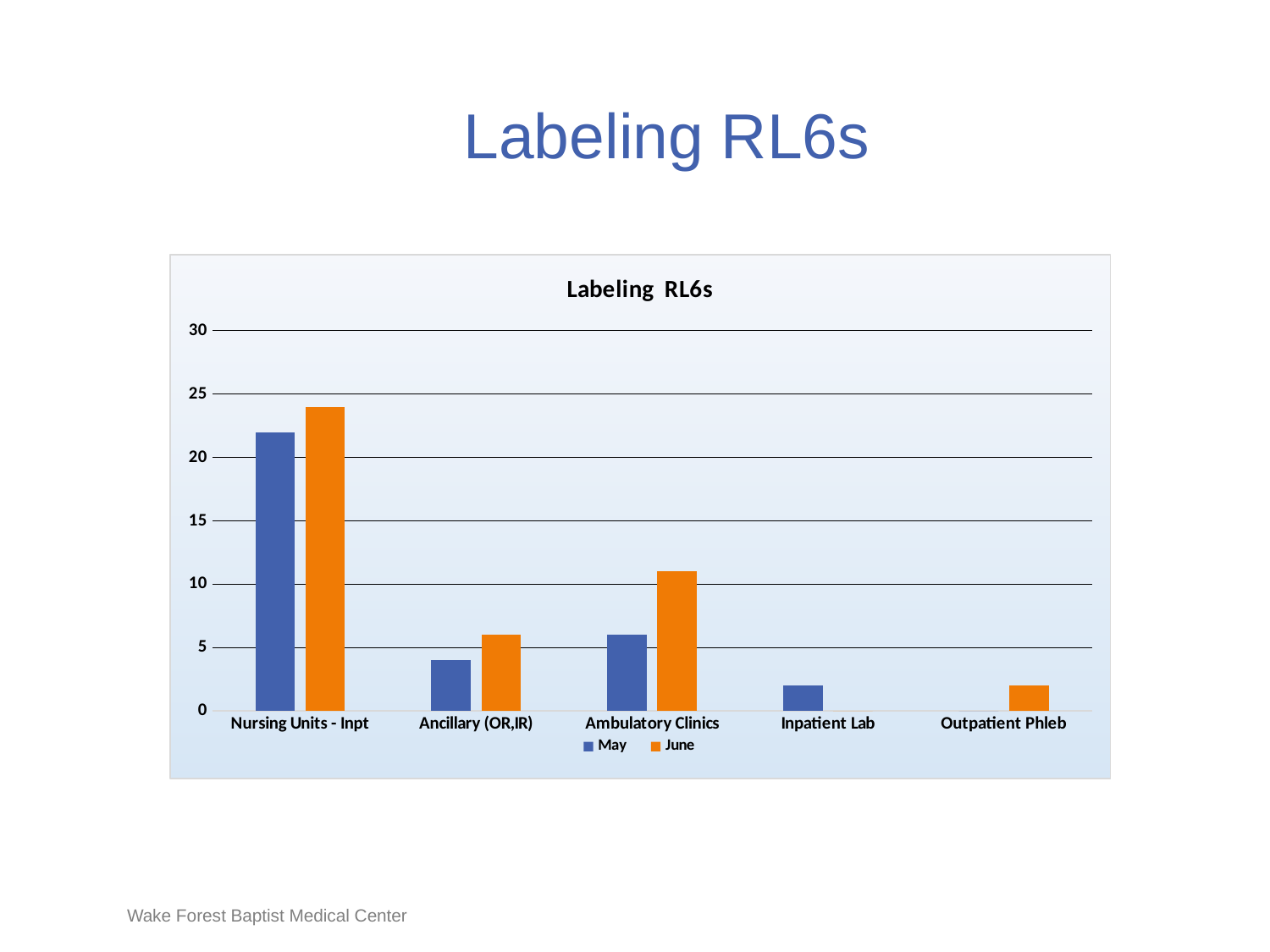
Is the May value for Inpatient Lab greater or less than 5? less What is the title of the chart? Labeling RL6s Is the May value for Ancillary (OR,IR) greater or less than 5? less Which series are listed in the legend? May and June Is the June value for Nursing Units - Inpt greater or less than 20? greater How many categories are shown on the x axis? 5 For Ambulatory Clinics, which is larger, the May value or the June value? June Which category has the highest June value? Nursing Units - Inpt Which category has the highest May value? Nursing Units - Inpt What kind of chart is shown on the slide? bar chart How many series does the legend list? 2